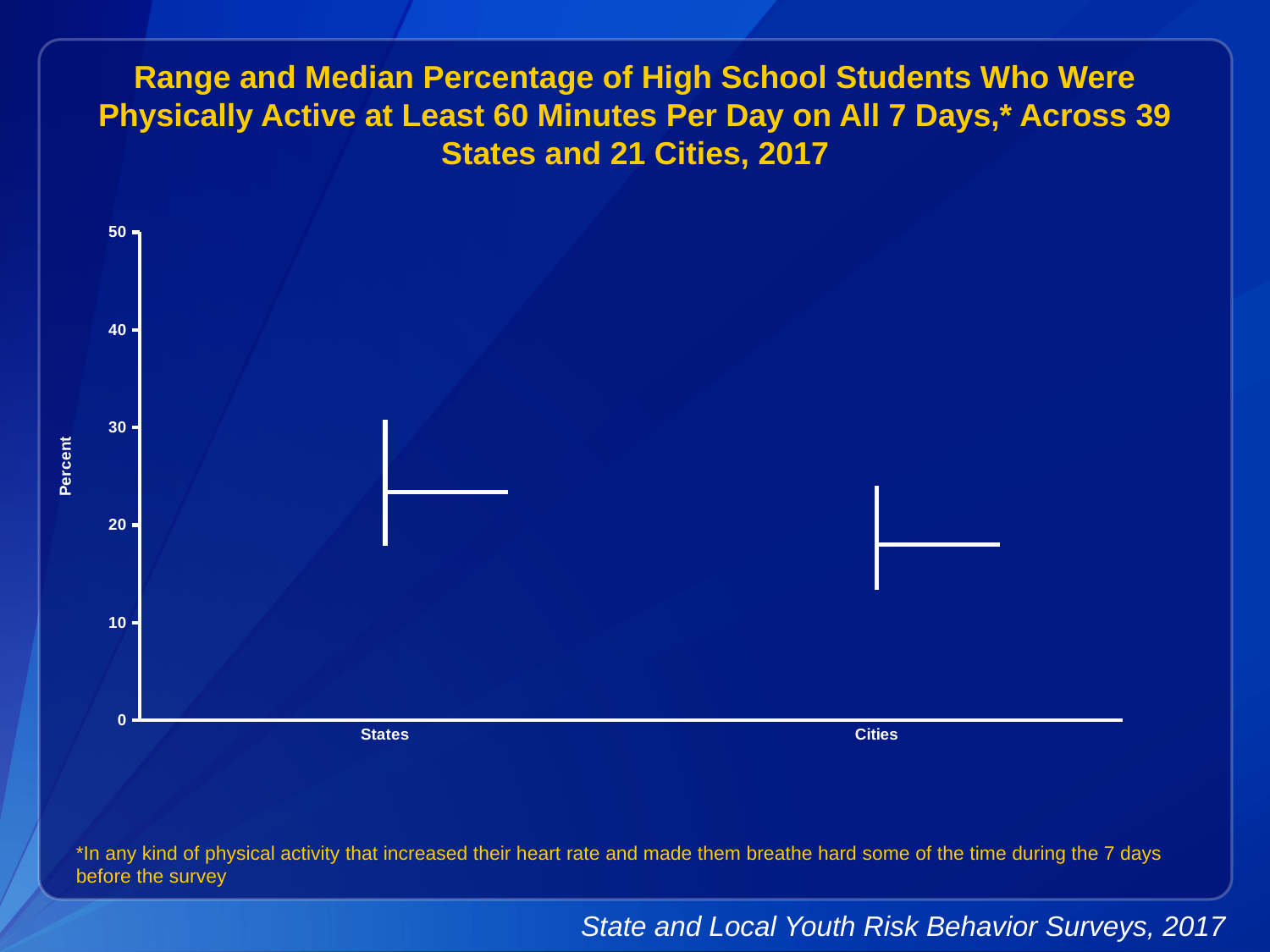
Is the highest value in the range for States greater or less than 40? less What is the maximum value shown on the y axis of the chart? 50 Is the median value for States greater or less than 20? greater Is the highest value in the range for Cities greater or less than 20? greater Which category has the higher top of its range, States or Cities? States Which category has the higher median percentage, States or Cities? States How many categories are shown on the x axis of the chart? 2 What is the label on the y axis of the chart? Percent What are the two categories shown on the x axis? States and Cities